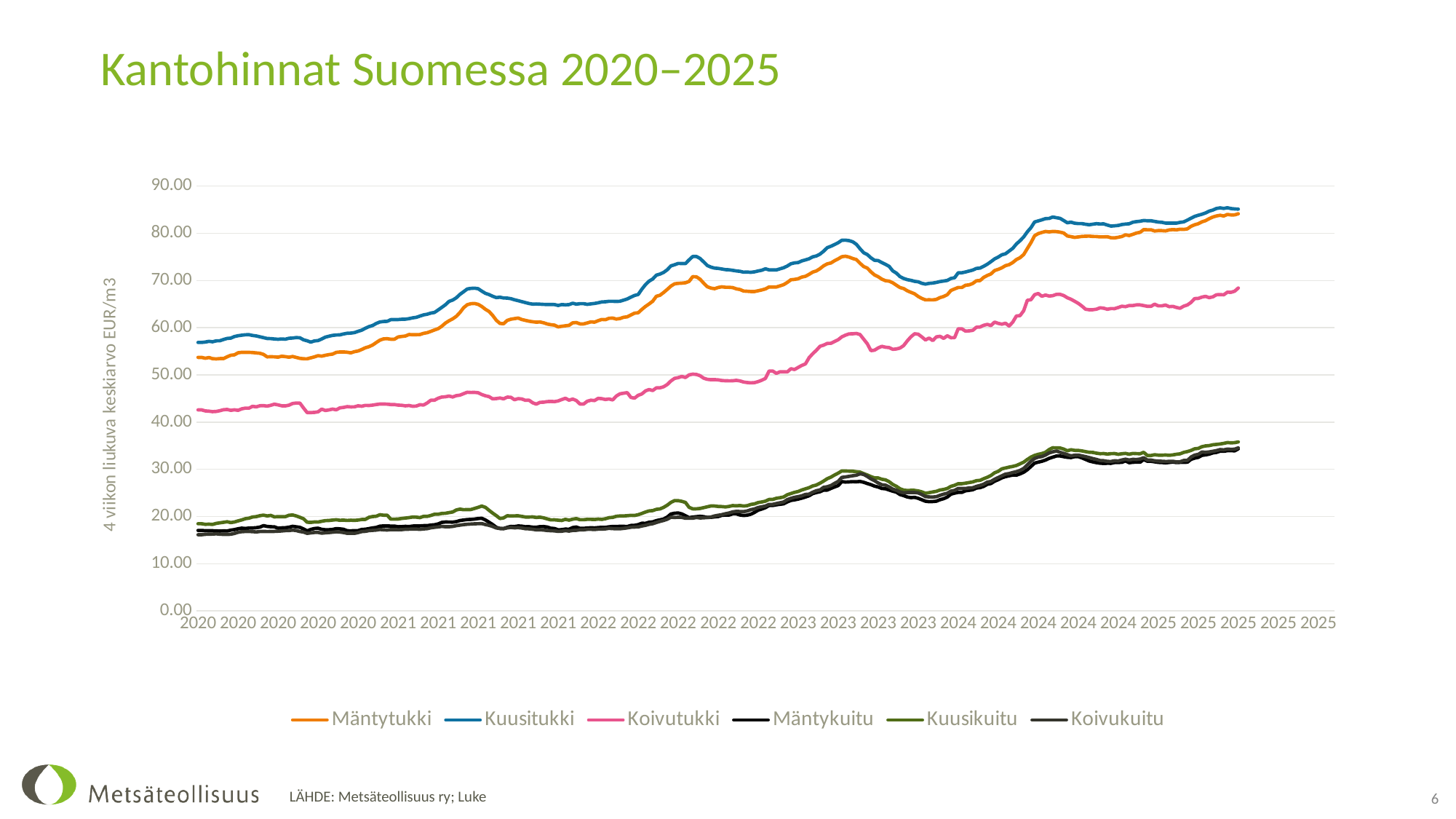
Which is larger throughout the period, Koivutukki or Kuusikuitu? Koivutukki Is the value for Kuusitukki at the end of 2025 greater or less than 80? greater What is the title of the chart? Kantohinnat Suomessa 2020–2025 How many series does the legend list? 6 Is the value for Koivutukki at the start of 2020 greater or less than 50? less Which is larger in 2023, Kuusitukki or Koivutukki? Kuusitukki Is the value for Mäntytukki at the start of 2020 greater or less than 60? less Do the values for Koivutukki generally rise or fall from 2020 to 2025? rise What kind of chart is shown on the slide? line chart Which series has the highest values at the start of 2020? Kuusitukki What is the label on the vertical axis? 4 viikon liukuva keskiarvo EUR/m3